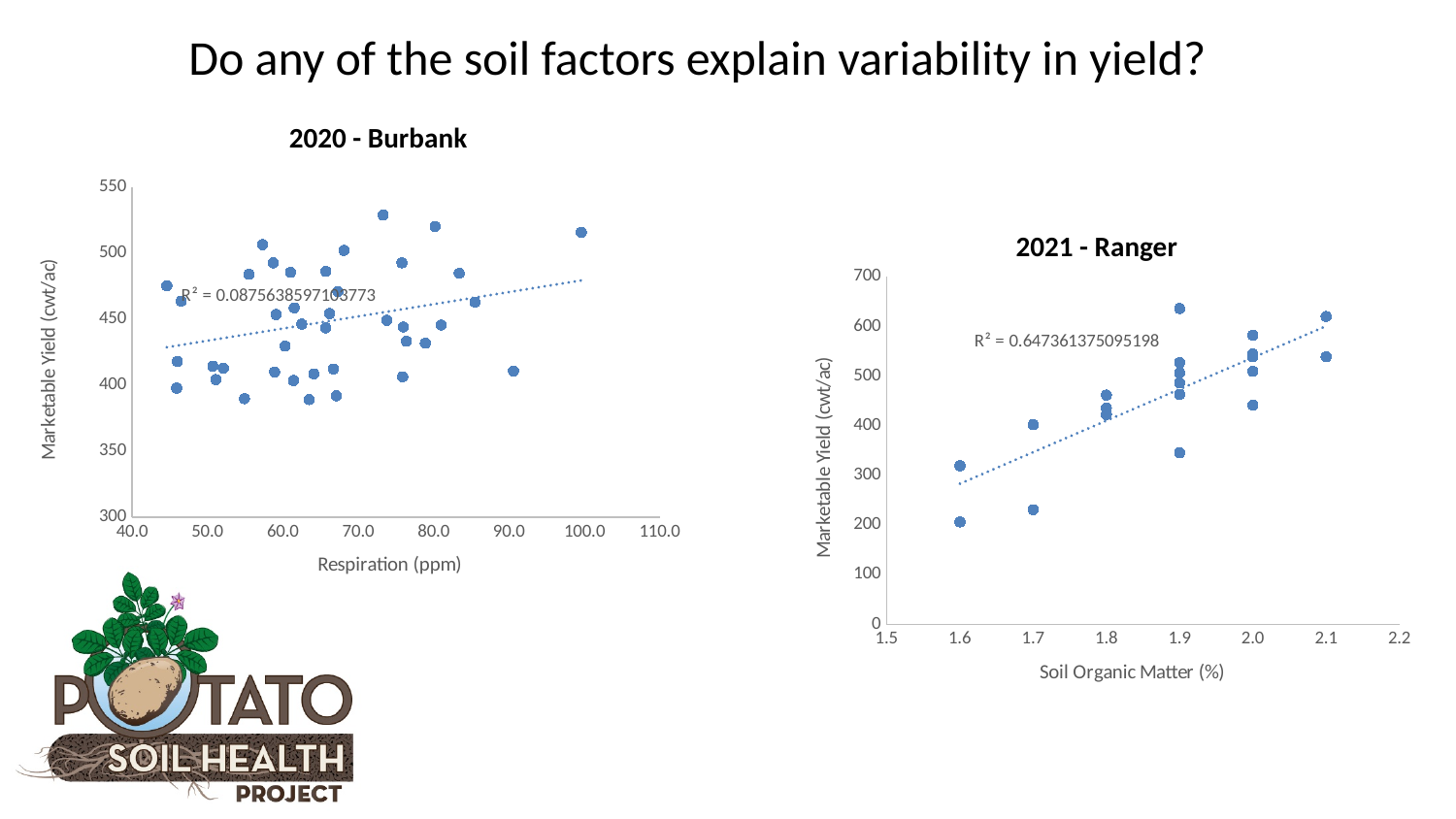
In the "2021 - Ranger" chart, does marketable yield generally rise or fall as soil organic matter increases? Rise In the "2020 - Burbank" chart, does the dotted trend line rise or fall as respiration increases? Rise In the "2020 - Burbank" chart, is the highest marketable yield point greater or less than 500? greater In the "2021 - Ranger" chart, is the highest marketable yield point greater or less than 600? greater What is the x-axis label of the "2021 - Ranger" chart? Soil Organic Matter (%) In the "2021 - Ranger" chart, is the lowest marketable yield point greater or less than 300? less What is the x-axis label of the "2020 - Burbank" chart? Respiration (ppm) Which chart shows the higher R² value, "2020 - Burbank" or "2021 - Ranger"? 2021 - Ranger In the "2021 - Ranger" chart, what R² value is printed? R² = 0.647361375095198 How many charts are shown on the slide? 2 What kind of chart is the "2020 - Burbank" chart? Scatter chart What kind of chart is the "2021 - Ranger" chart? Scatter chart